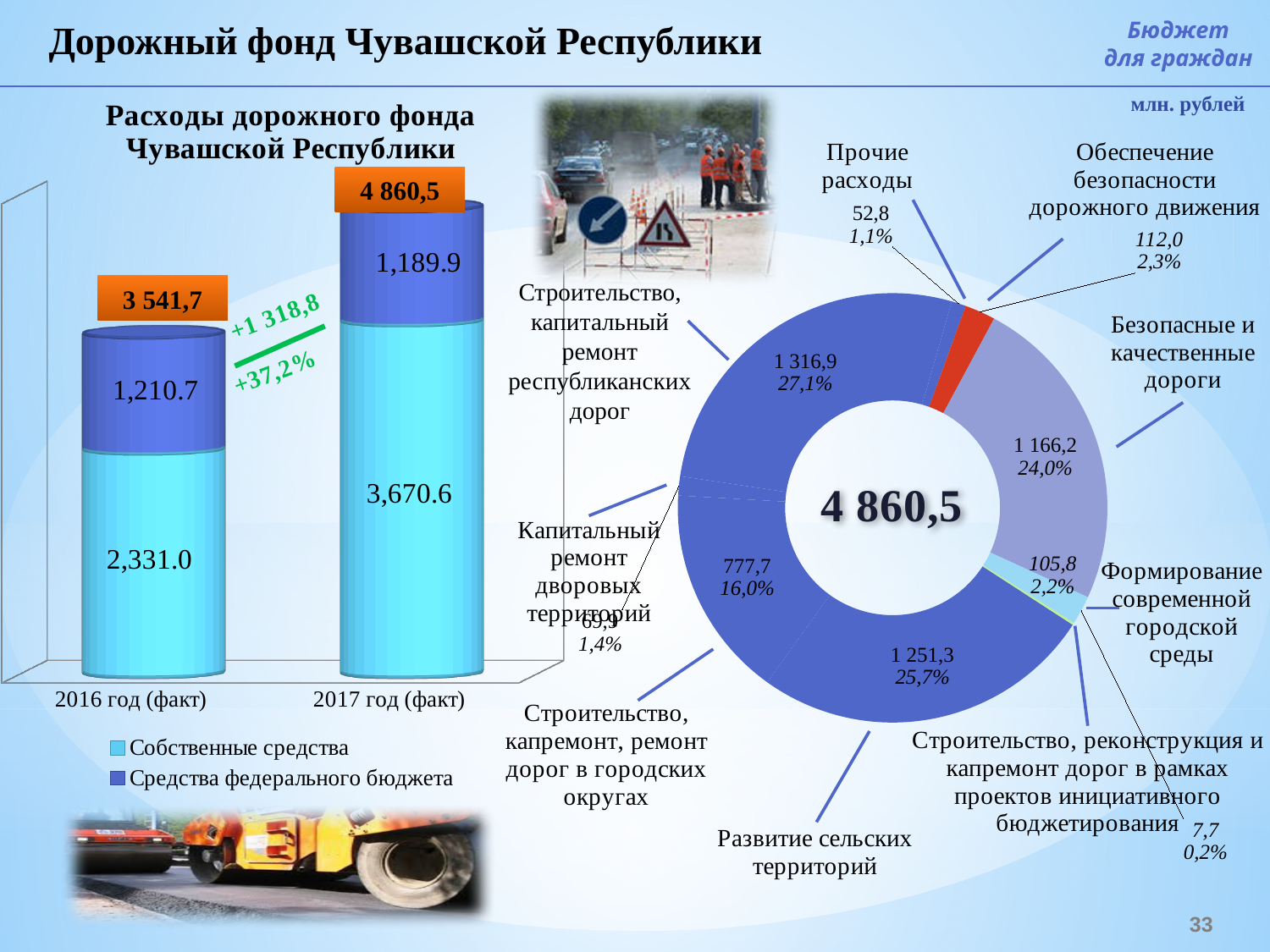
In the bar chart 'Расходы дорожного фонда Чувашской Республики', what is the difference between Собственные средства in 2017 and in 2016? 1,339.6 What kind of chart is the chart on the right side of the slide showing 4 860,5 in the centre? Donut (pie) chart In the donut chart on the right, which category has the largest value? Строительство, капитальный ремонт республиканских дорог In the donut chart on the right, what share does Безопасные и качественные дороги have? 24,0% In the bar chart 'Расходы дорожного фонда Чувашской Республики', what is the total of the stacked bar for 2016 год (факт)? 3 541,7 In the bar chart 'Расходы дорожного фонда Чувашской Республики', what is the value of Средства федерального бюджета for 2016 год (факт)? 1,210.7 In the donut chart on the right, how many categories are shown? 9 In the donut chart on the right, which category has the smallest value? Строительство, реконструкция и капремонт дорог в рамках проектов инициативного бюджетирования In the bar chart 'Расходы дорожного фонда Чувашской Республики', what is the value of Собственные средства for 2017 год (факт)? 3,670.6 In the bar chart 'Расходы дорожного фонда Чувашской Республики', which year has the larger value of Средства федерального бюджета, 2016 or 2017? 2016 год (факт) In the donut chart on the right, what is the value for Развитие сельских территорий? 1 251,3 In the bar chart 'Расходы дорожного фонда Чувашской Республики', how many series does the legend list? 2